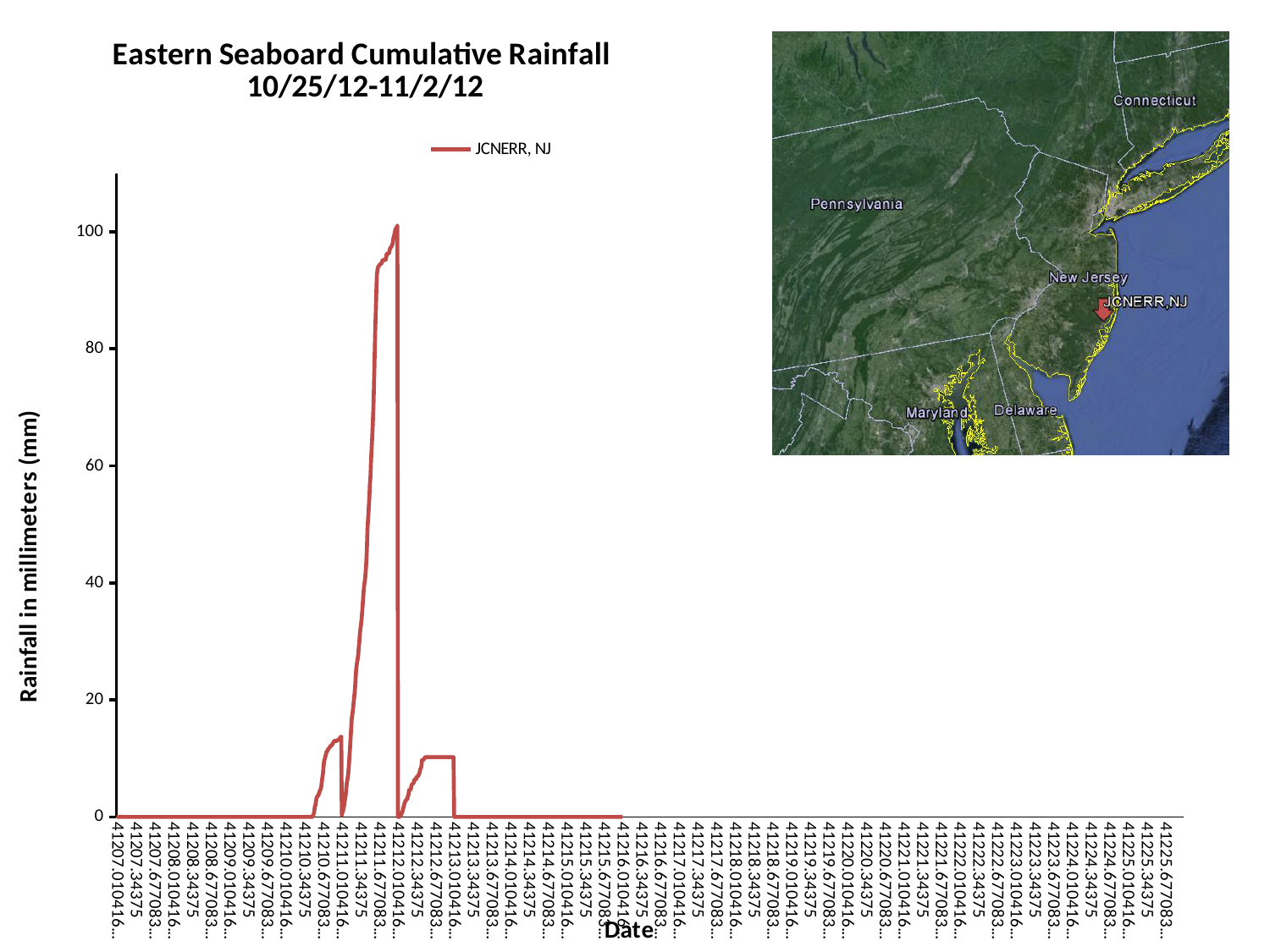
Is the value for JCNERR, NJ at 41211.677083 greater or less than 60? greater How many series does the chart's legend list? 1 What is the title of the chart? Eastern Seaboard Cumulative Rainfall 10/25/12-11/2/12 Is the value for JCNERR, NJ at 41208.010416 greater or less than 20? less What series name appears in the chart's legend? JCNERR, NJ Between 41211.010416 and 41211.677083, does the JCNERR, NJ line rise or fall? rise What kind of chart is shown on the slide? line chart Is the peak value of the JCNERR, NJ line greater or less than 80? greater Between 41212.677083 and 41213.34375, does the JCNERR, NJ line rise or fall? fall